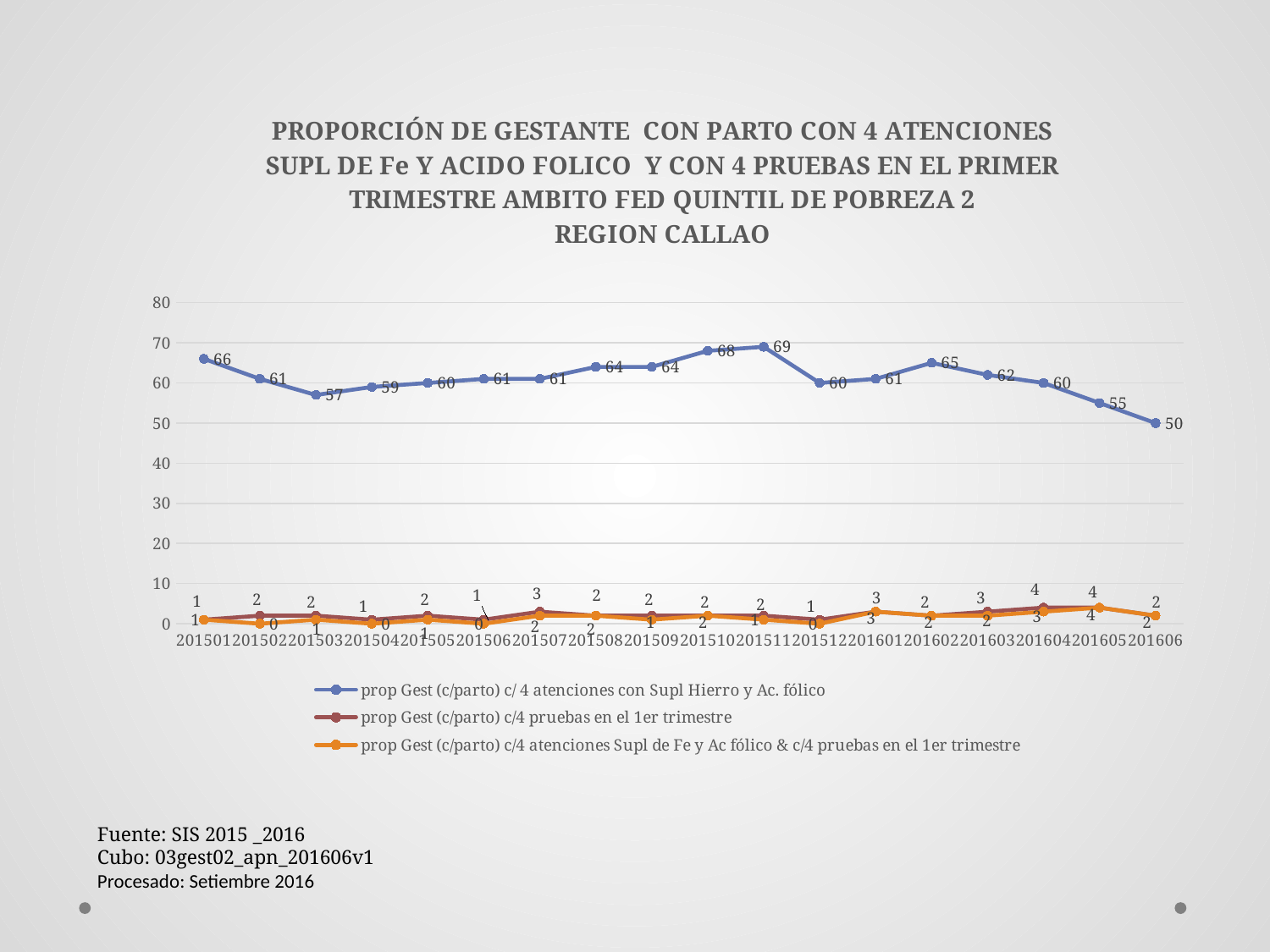
In which period does 'prop Gest (c/parto) c/ 4 atenciones con Supl Hierro y Ac. fólico' reach its lowest value? 201606 From 201603 to 201606, does 'prop Gest (c/parto) c/ 4 atenciones con Supl Hierro y Ac. fólico' rise or fall? fall What is the value of 'prop Gest (c/parto) c/ 4 atenciones con Supl Hierro y Ac. fólico' for 201501? 66 In which period does 'prop Gest (c/parto) c/ 4 atenciones con Supl Hierro y Ac. fólico' reach its highest value? 201511 What is the value of 'prop Gest (c/parto) c/ 4 atenciones con Supl Hierro y Ac. fólico' for 201511? 69 Is the value of 'prop Gest (c/parto) c/ 4 atenciones con Supl Hierro y Ac. fólico' for 201510 greater or less than 60? greater How many periods are plotted along the x axis? 18 What type of chart is shown on the slide? line chart What is the value of 'prop Gest (c/parto) c/ 4 atenciones con Supl Hierro y Ac. fólico' for 201606? 50 How many series does the legend list? 3 What is the difference between the 201511 and 201606 values of 'prop Gest (c/parto) c/ 4 atenciones con Supl Hierro y Ac. fólico'? 19 Which is larger for 'prop Gest (c/parto) c/ 4 atenciones con Supl Hierro y Ac. fólico': the value for 201503 or the value for 201602? 201602